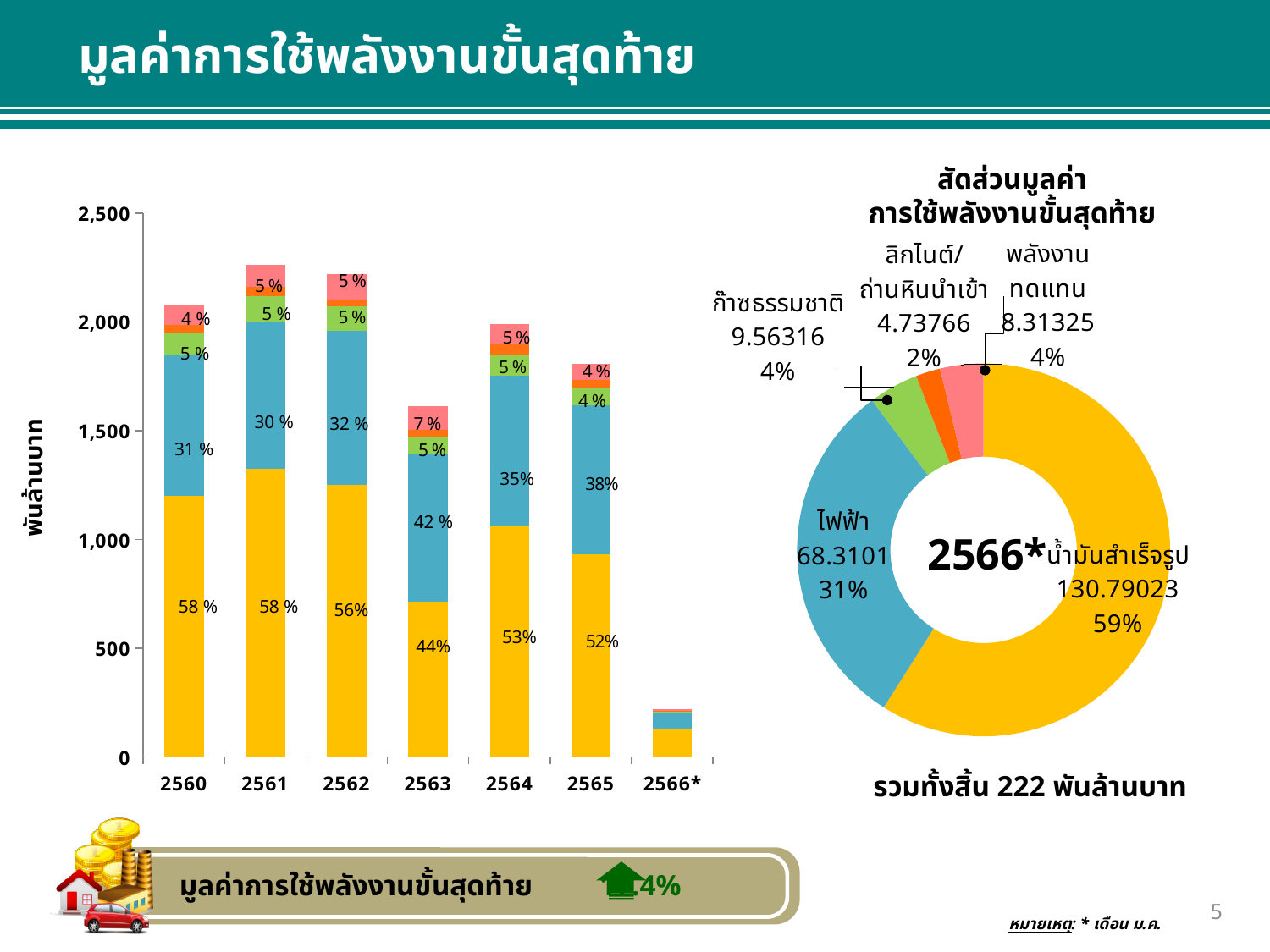
How many categories are shown in the donut chart on the right? 5 In the bar chart on the left, which bar is taller, 2563 or 2564? 2564 In the bar chart on the left, is the total bar height for 2561 greater or less than 2,000? greater In the donut chart on the right, what value is shown for น้ำมันสำเร็จรูป? 130.79023 In the bar chart on the left, what percentage label is shown on the yellow segment for 2563? 44% In the donut chart on the right, what is the difference between the values for ไฟฟ้า and ก๊าซธรรมชาติ? 58.74694 How many years are shown on the x axis of the bar chart on the left? 7 In the donut chart on the right, which category has the largest share? น้ำมันสำเร็จรูป What total is stated below the donut chart on the right? 222 พันล้านบาท In the donut chart on the right, what share of the total does ไฟฟ้า account for? 31% In the donut chart on the right, which category has the smallest share? ลิกไนต์/ถ่านหินนำเข้า What kind of chart is the chart on the left of the slide? Stacked bar chart